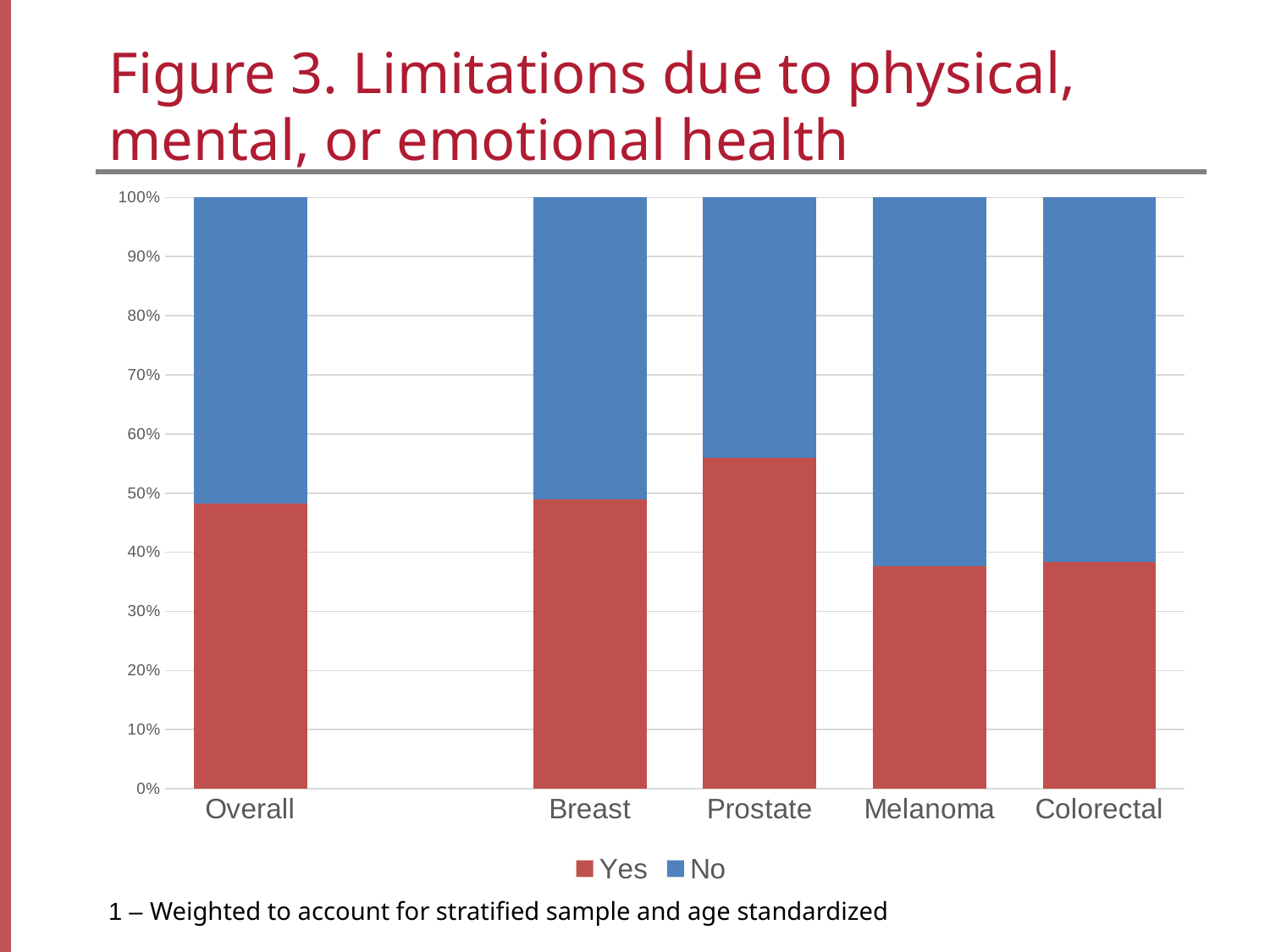
Is the 'No' share for Colorectal greater or less than 60%? greater Which category has the highest share of 'Yes' responses? Prostate Is the 'Yes' share for Prostate greater or less than 50%? greater Which has a larger 'No' share, Melanoma or Breast? Melanoma What kind of chart is shown on the slide? Stacked bar chart How many series does the chart's legend list? 2 Which has a larger 'Yes' share, Prostate or Melanoma? Prostate Is the 'Yes' share for Overall greater or less than 50%? less How many categories are shown on the x axis of the chart? 5 Which colour represents the 'Yes' series in the chart? Red What is the total height of each stacked bar in the chart? 100%